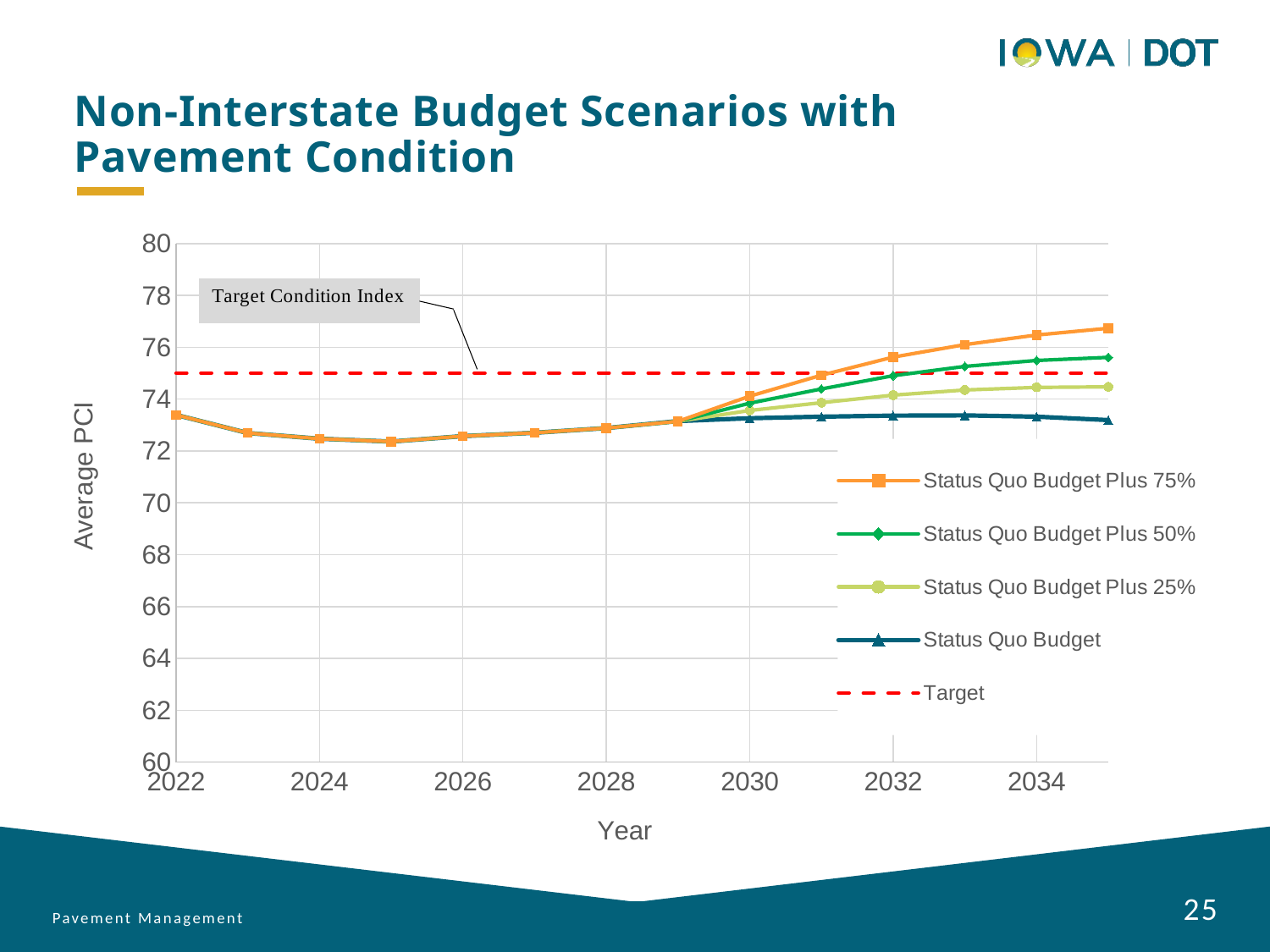
How many series does the legend list? 5 Which series has the lowest Average PCI in 2035? Status Quo Budget What kind of chart is shown on the slide? line chart Is the value for Status Quo Budget in 2035 greater or less than 74? less Which series has the highest Average PCI in 2035? Status Quo Budget Plus 75% Is the value for Status Quo Budget Plus 50% in 2035 greater or less than 74? greater What does the text box pointing to the dashed red line say? Target Condition Index Is the value for Status Quo Budget Plus 75% in 2035 greater or less than 76? greater Does the Status Quo Budget Plus 75% line rise or fall from 2030 to 2035? rise What is the label on the y axis? Average PCI In 2034, which is larger: Status Quo Budget Plus 50% or Status Quo Budget Plus 25%? Status Quo Budget Plus 50%